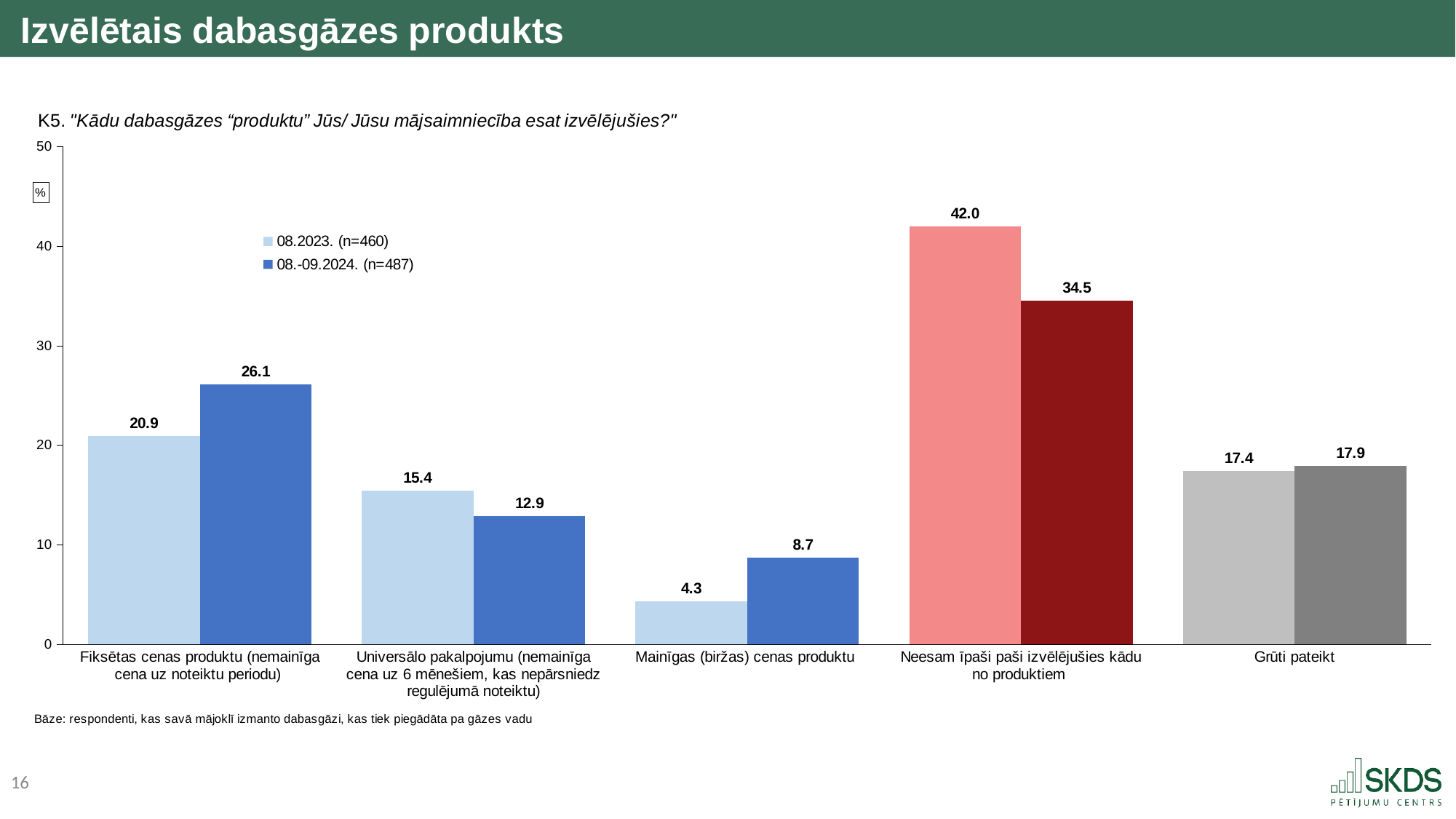
How many categories are shown on the x axis? 5 How many series does the legend list? 2 What is the value for "Neesam īpaši paši izvēlējušies kādu no produktiem" in the 08.2023. (n=460) series? 42.0 What kind of chart is shown on the slide? bar chart What is the difference between the 08.-09.2024. and 08.2023. values for "Mainīgas (biržas) cenas produktu"? 4.4 What is the value for "Mainīgas (biržas) cenas produktu" in the 08.2023. (n=460) series? 4.3 Which category has the highest value in the 08.-09.2024. (n=487) series? Neesam īpaši paši izvēlējušies kādu no produktiem Is the 08.-09.2024. value for "Grūti pateikt" greater or less than 20? less Which category has the lowest value in the 08.2023. (n=460) series? Mainīgas (biržas) cenas produktu What is the value for "Fiksētas cenas produktu (nemainīga cena uz noteiktu periodu)" in the 08.-09.2024. (n=487) series? 26.1 What is the difference between the 08.2023. and 08.-09.2024. values for "Neesam īpaši paši izvēlējušies kādu no produktiem"? 7.5 For "Universālo pakalpojumu", which series has the larger value: 08.2023. (n=460) or 08.-09.2024. (n=487)? 08.2023. (n=460)